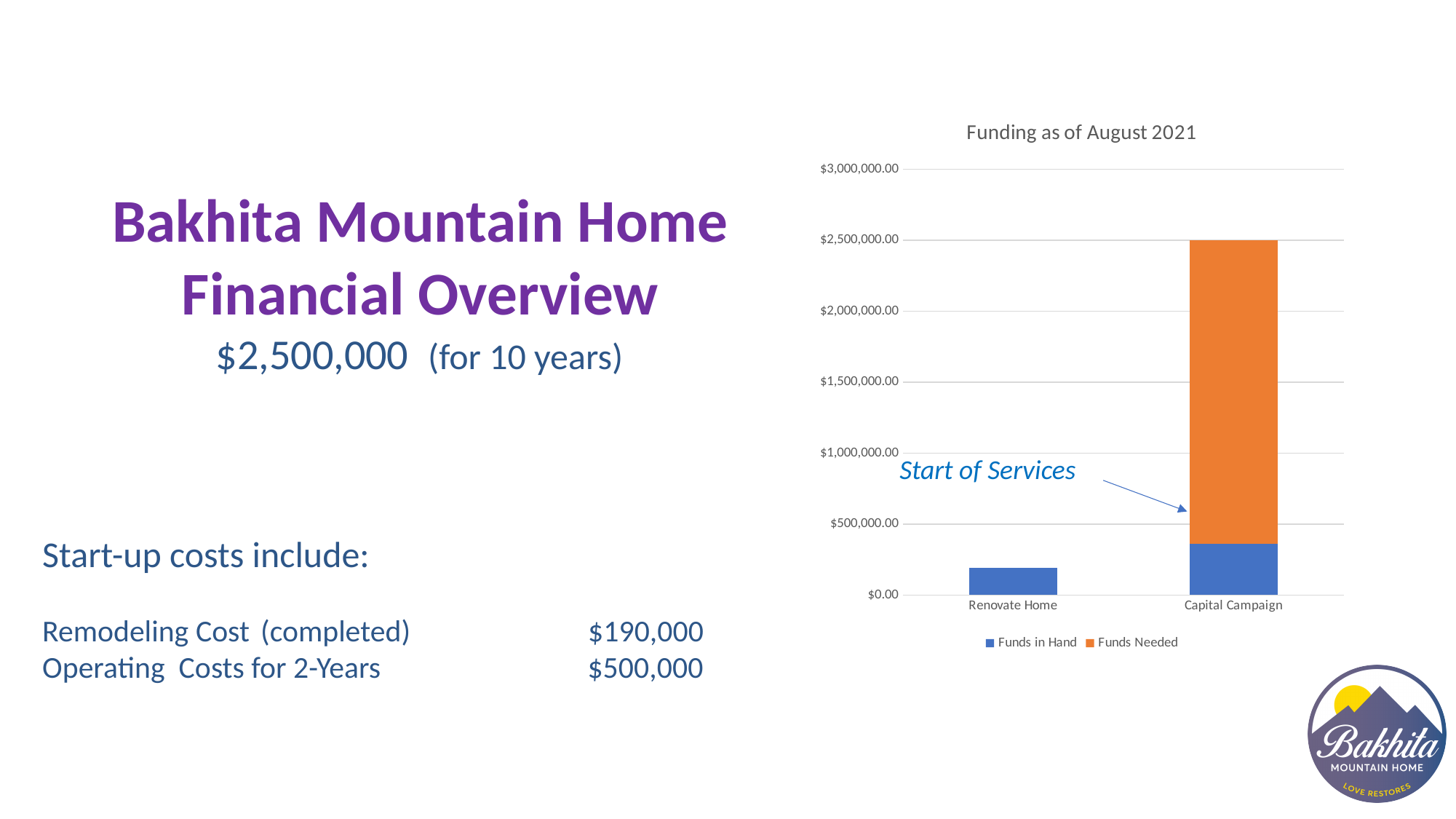
How many categories are shown on the x axis of the chart? 2 Is the total bar for Renovate Home greater or less than $500,000.00? less How many series does the chart legend list? 2 Which is larger, the total bar for Capital Campaign or the total bar for Renovate Home? Capital Campaign Which category has the shortest bar in the chart? Renovate Home Is the total stacked bar for Capital Campaign greater or less than $2,000,000.00? greater What is the total of the stacked bar for Capital Campaign, as read from the axis gridline it reaches? $2,500,000.00 Is the Funds in Hand value for Capital Campaign greater or less than $500,000.00? less Which category has the tallest bar in the chart? Capital Campaign What kind of chart is shown on the slide? bar chart Which colour represents the Funds Needed series in the chart? orange What is the title of the chart? Funding as of August 2021